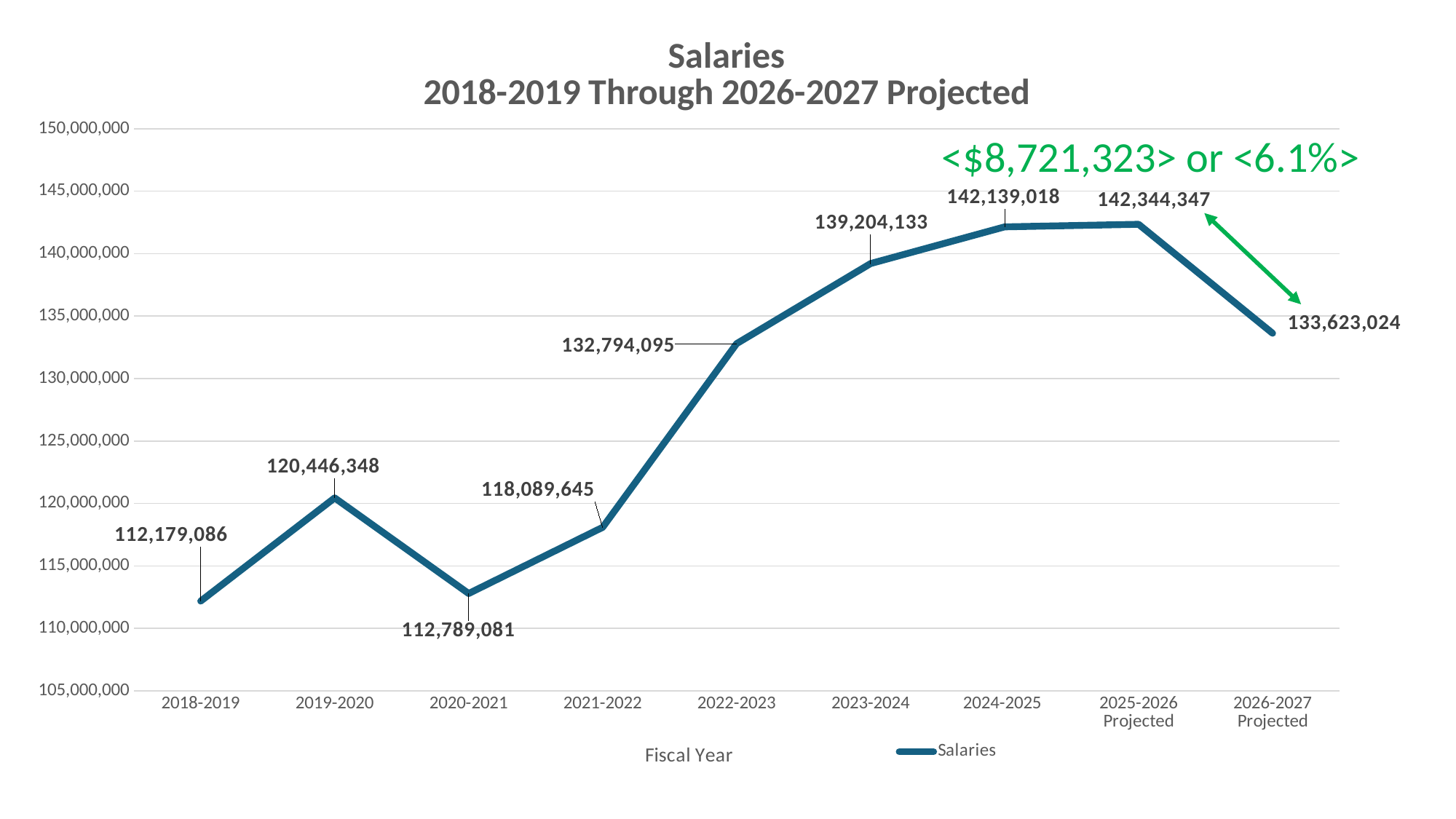
What is the difference between the 2025-2026 Projected and 2026-2027 Projected salary values? 8,721,323 What is the salary value for 2020-2021? 112,789,081 Which fiscal year has the lowest salary value? 2018-2019 What kind of chart is shown on the slide? Line chart How many series does the legend list? 1 What is the salary value for 2022-2023? 132,794,095 What is the difference between the 2019-2020 and 2018-2019 salary values? 8,267,262 What is the projected salary value for 2026-2027? 133,623,024 Which fiscal year has the highest salary value? 2025-2026 Projected How many fiscal years are plotted on the chart? 9 Do the salary values rise or fall from 2021-2022 to 2025-2026 Projected? Rise Which is larger, the salary value for 2019-2020 or for 2021-2022? 2019-2020